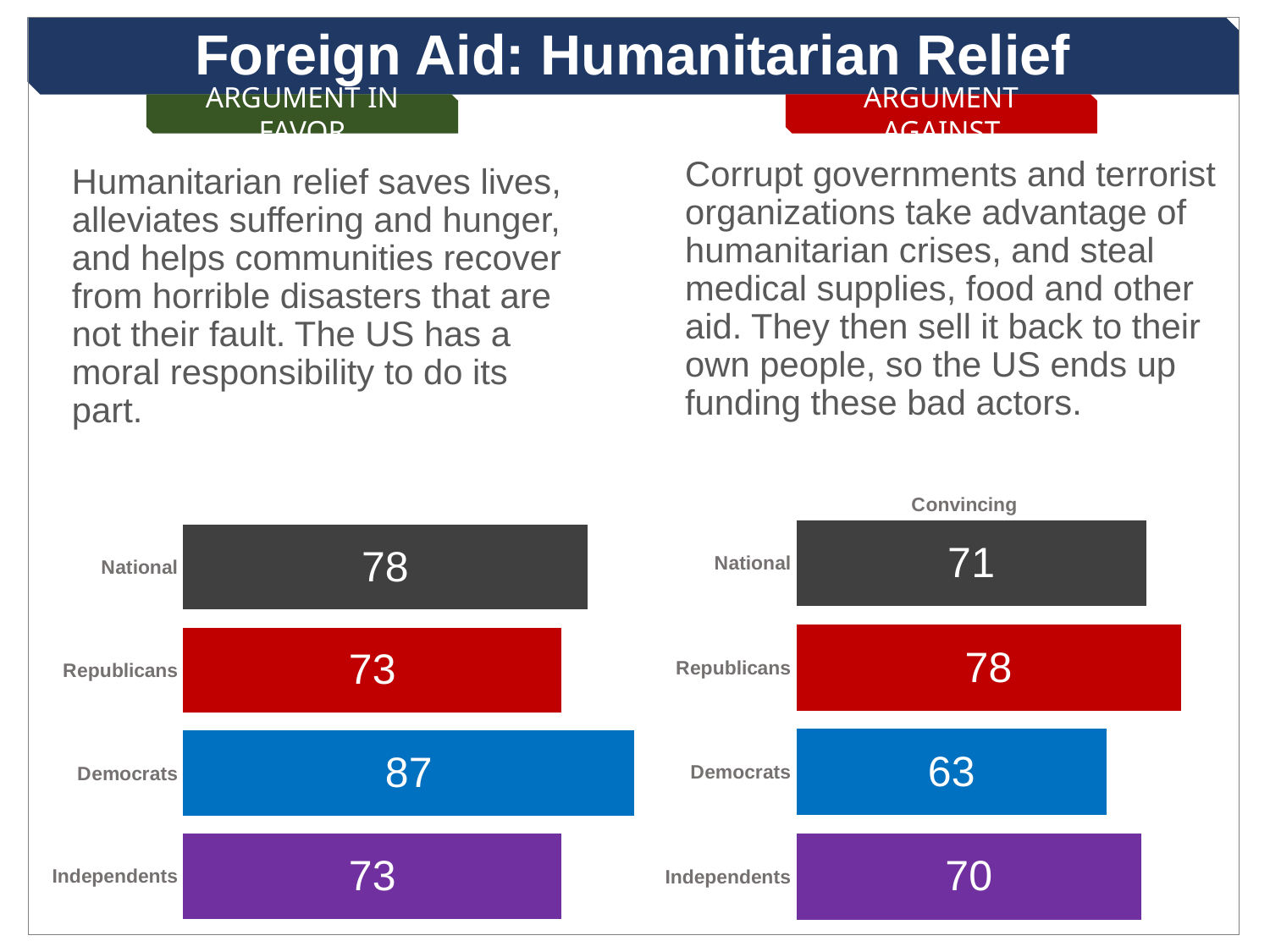
In the right chart (Argument Against), what is the value for Independents? 70 Which is larger: the National value in the left chart (Argument in Favor) or the National value in the right chart (Argument Against)? Left chart (Argument in Favor), 78 In the left chart (Argument in Favor), which category has the highest value? Democrats What type of chart is used on the right side (Argument Against)? Bar chart In the right chart (Argument Against), what is the difference between the values for Republicans and Democrats? 15 What colour is the Democrats bar in the left chart (Argument in Favor)? Blue In the right chart (Argument Against), which category has the lowest value? Democrats In the right chart (Argument Against), which category has the highest value? Republicans In the left chart (Argument in Favor), what is the value for Democrats? 87 In the left chart (Argument in Favor), what is the difference between the values for Democrats and Republicans? 14 How many categories are shown in the left chart (Argument in Favor)? 4 In the right chart (Argument Against), what is the value for National? 71